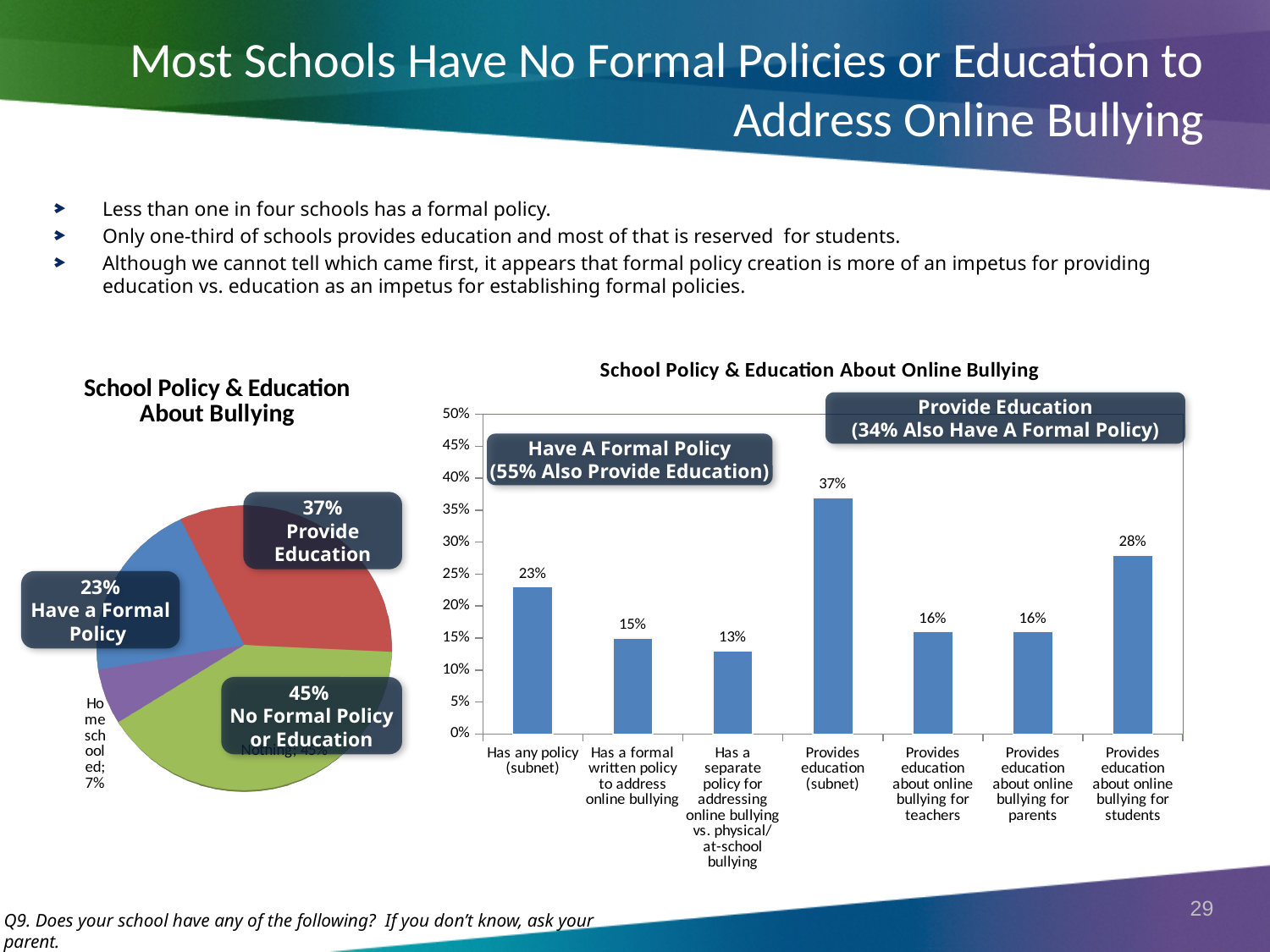
In the pie chart titled 'School Policy & Education About Bullying', what share is labelled 'No Formal Policy or Education'? 45% In the bar chart titled 'School Policy & Education About Online Bullying', which category has the lowest value? Has a separate policy for addressing online bullying vs. physical/at-school bullying In the bar chart titled 'School Policy & Education About Online Bullying', what percentage of those who have a formal policy also provide education, according to the callout box? 55% In the bar chart titled 'School Policy & Education About Online Bullying', what is the difference between 'Provides education (subnet)' and 'Has any policy (subnet)'? 14% In the bar chart titled 'School Policy & Education About Online Bullying', what is the value for 'Provides education about online bullying for students'? 28% In the pie chart titled 'School Policy & Education About Bullying', what share is labelled 'Have a Formal Policy'? 23% In the bar chart titled 'School Policy & Education About Online Bullying', what is the value for 'Provides education (subnet)'? 37% In the bar chart titled 'School Policy & Education About Online Bullying', which category has the highest value? Provides education (subnet) In the bar chart titled 'School Policy & Education About Online Bullying', which is larger: the value for education for students or the value for education for teachers? Education for students In the bar chart titled 'School Policy & Education About Online Bullying', what is the value for 'Has a formal written policy to address online bullying'? 15% In the bar chart titled 'School Policy & Education About Online Bullying', how many categories are shown on the x axis? 7 What kind of chart is the chart on the right titled 'School Policy & Education About Online Bullying'? Bar chart